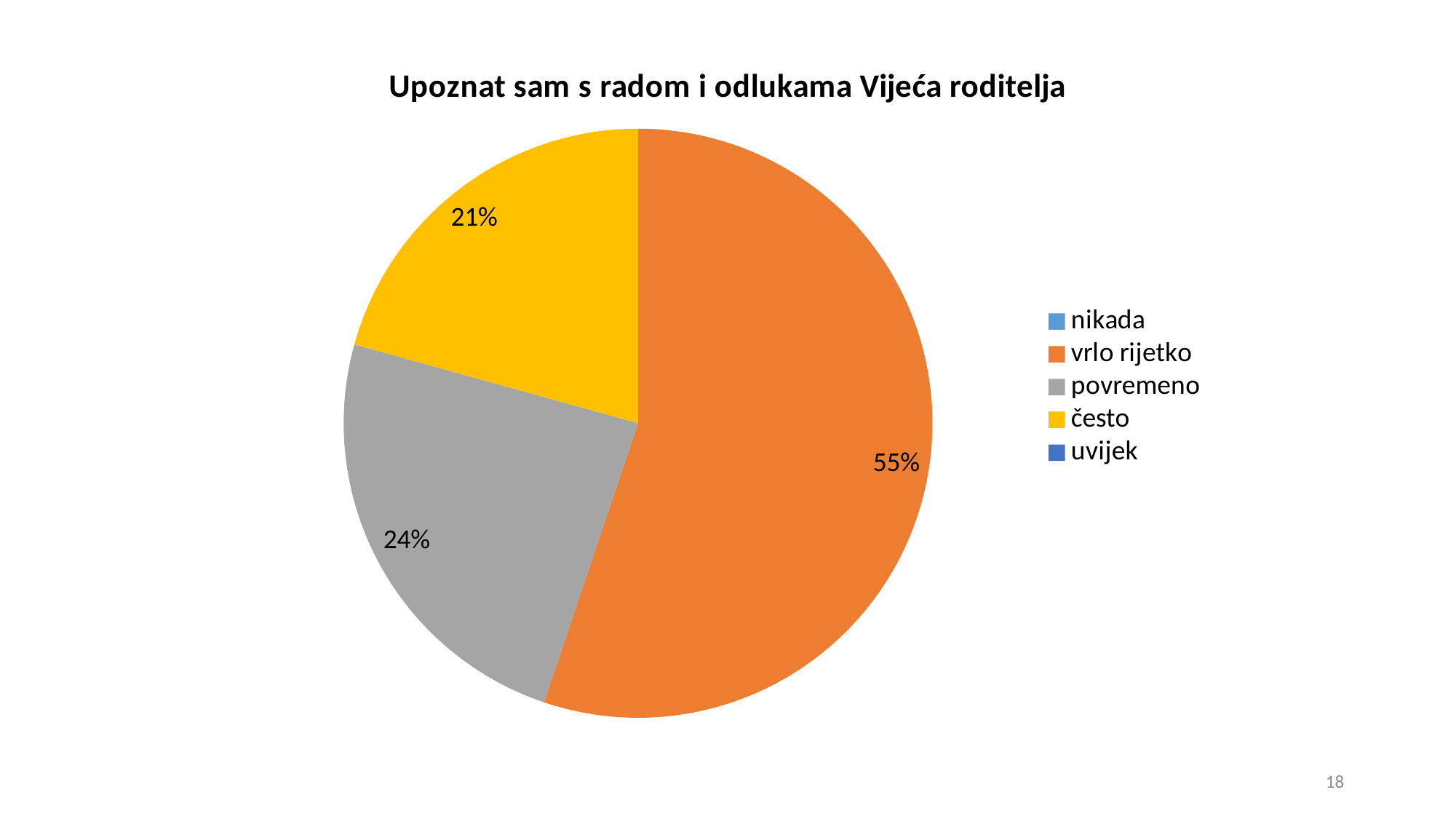
What percentage is shown for 'povremeno'? 24% How many entries does the legend list? 5 What percentage is shown for 'vrlo rijetko'? 55% Which is larger, the slice for 'povremeno' or the slice for 'često'? povremeno What percentage is shown for 'često'? 21% Which of the labelled slices is the smallest? često What colour is the slice for 'često'? yellow What is the difference between the 'vrlo rijetko' and 'povremeno' percentages? 31% What is the difference between the 'povremeno' and 'često' percentages? 3% Which category has the largest slice of the pie? vrlo rijetko What kind of chart is shown on the slide? pie chart What is the title of the chart? Upoznat sam s radom i odlukama Vijeća roditelja